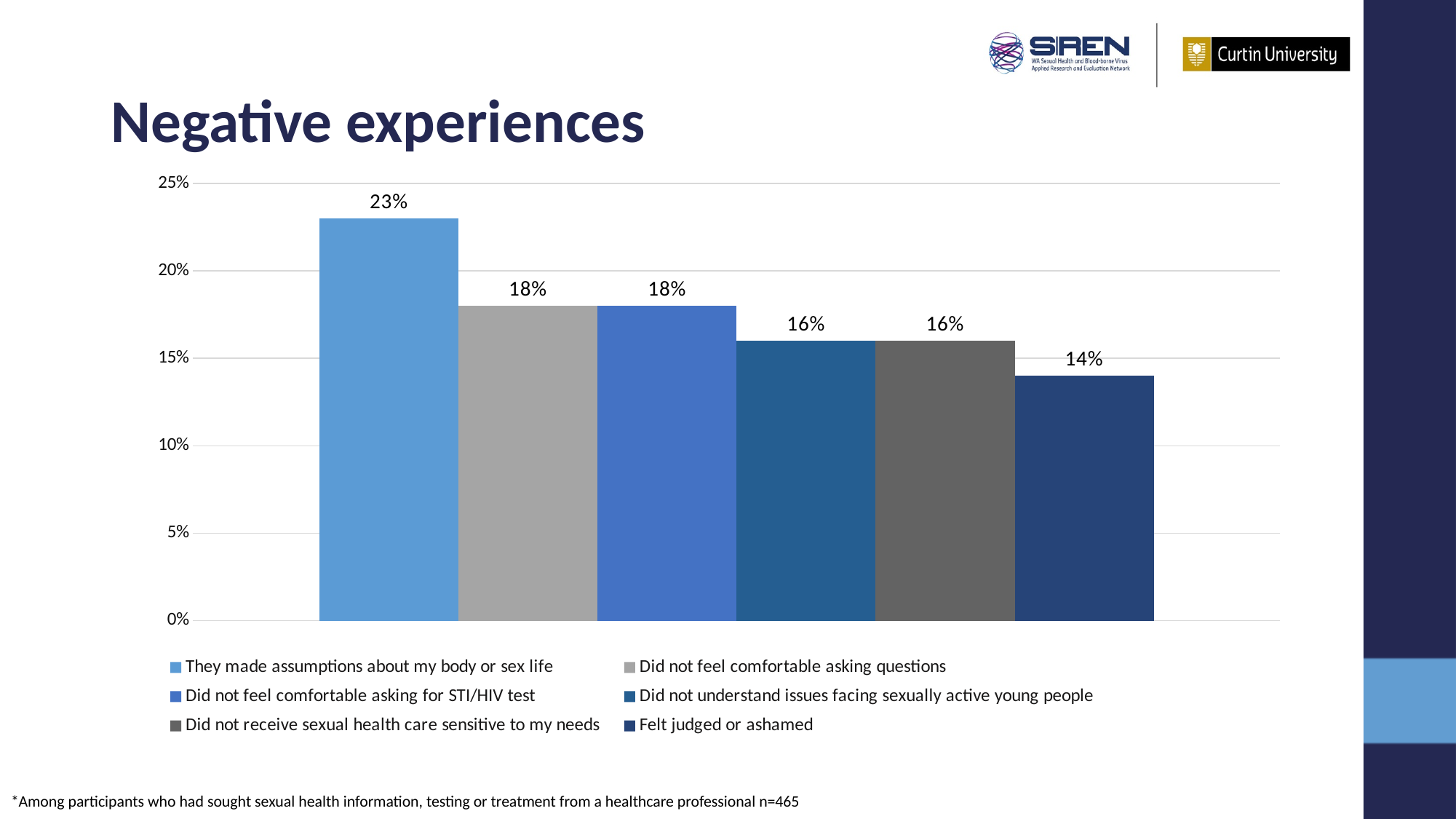
What is the difference between 'Did not feel comfortable asking questions' and 'Did not receive sexual health care sensitive to my needs'? 2% Which negative experience has the lowest percentage? Felt judged or ashamed What is the title of the slide? Negative experiences What is the difference between 'They made assumptions about my body or sex life' and 'Felt judged or ashamed'? 9% What is the value for 'Felt judged or ashamed'? 14% What type of chart is shown on the slide? Bar chart How many bars are shown in the chart? 6 Is the value for 'They made assumptions about my body or sex life' greater or less than 20%? greater Which negative experience has the highest percentage? They made assumptions about my body or sex life What is the value for 'Did not understand issues facing sexually active young people'? 16% Which is larger: 'Did not feel comfortable asking for STI/HIV test' or 'Felt judged or ashamed'? Did not feel comfortable asking for STI/HIV test What percentage of participants reported that they made assumptions about my body or sex life? 23%